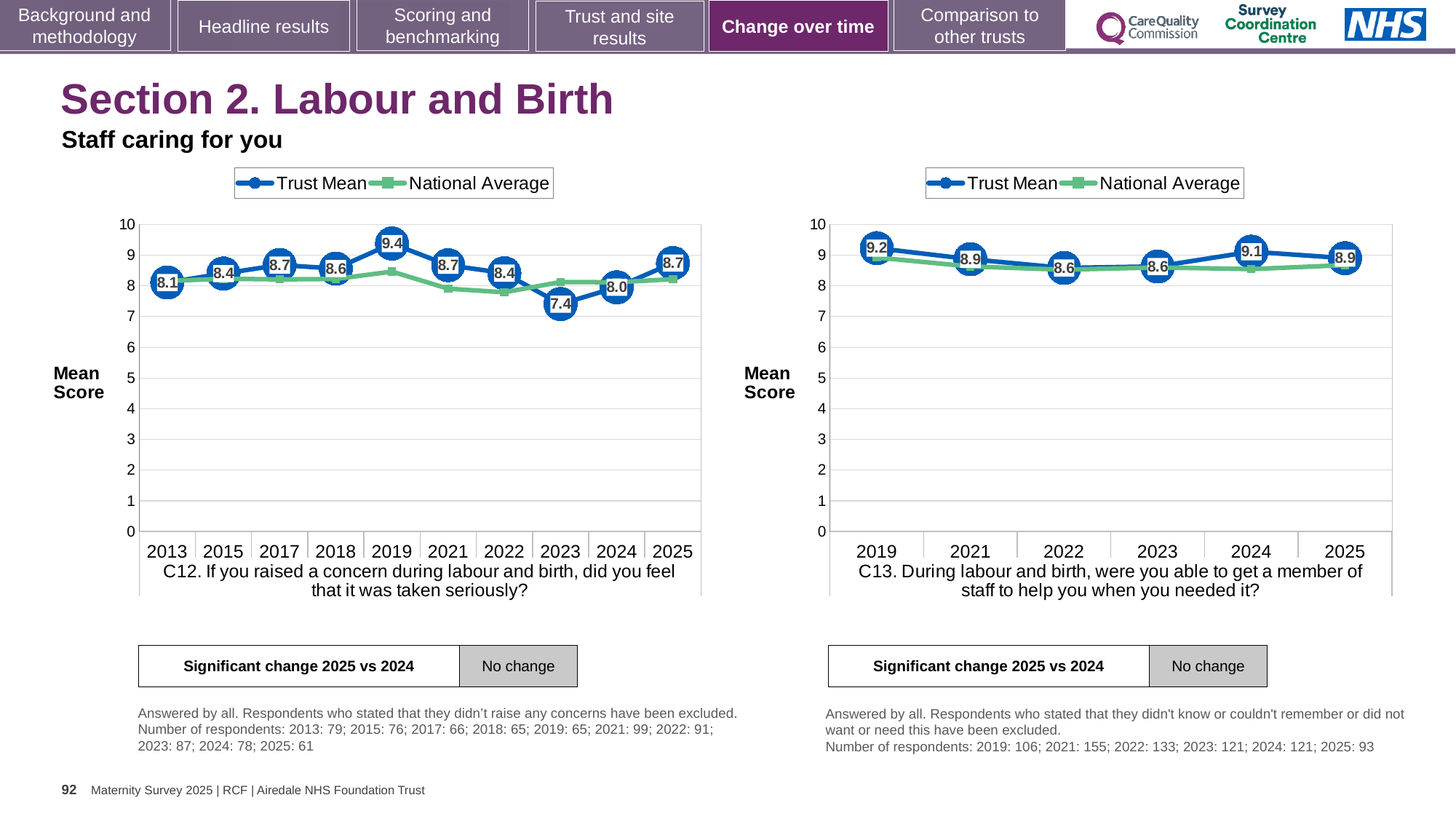
What kind of chart is the C12 chart on the left? Line chart In the C13 chart on the right, which is larger, the Trust Mean score for 2024 or for 2021? 2024 How many years are plotted on the x axis of the C13 chart on the right? 6 In the C13 chart on the right, what is the Trust Mean score for 2025? 8.9 In the C12 chart on the left, what is the difference between the Trust Mean scores for 2025 and 2024? 0.7 How many series does the legend of the C12 chart on the left list? 2 In the C12 chart on the left, which year has the highest Trust Mean score? 2019 In the C13 chart on the right, which year has the highest Trust Mean score? 2019 In the C12 chart on the left, which year has the lowest Trust Mean score? 2023 In the C13 chart on the right, is the National Average value for 2019 greater or less than 8? greater In the C12 chart on the left, what is the Trust Mean score for 2019? 9.4 In the C12 chart on the left, what is the Trust Mean score for 2023? 7.4